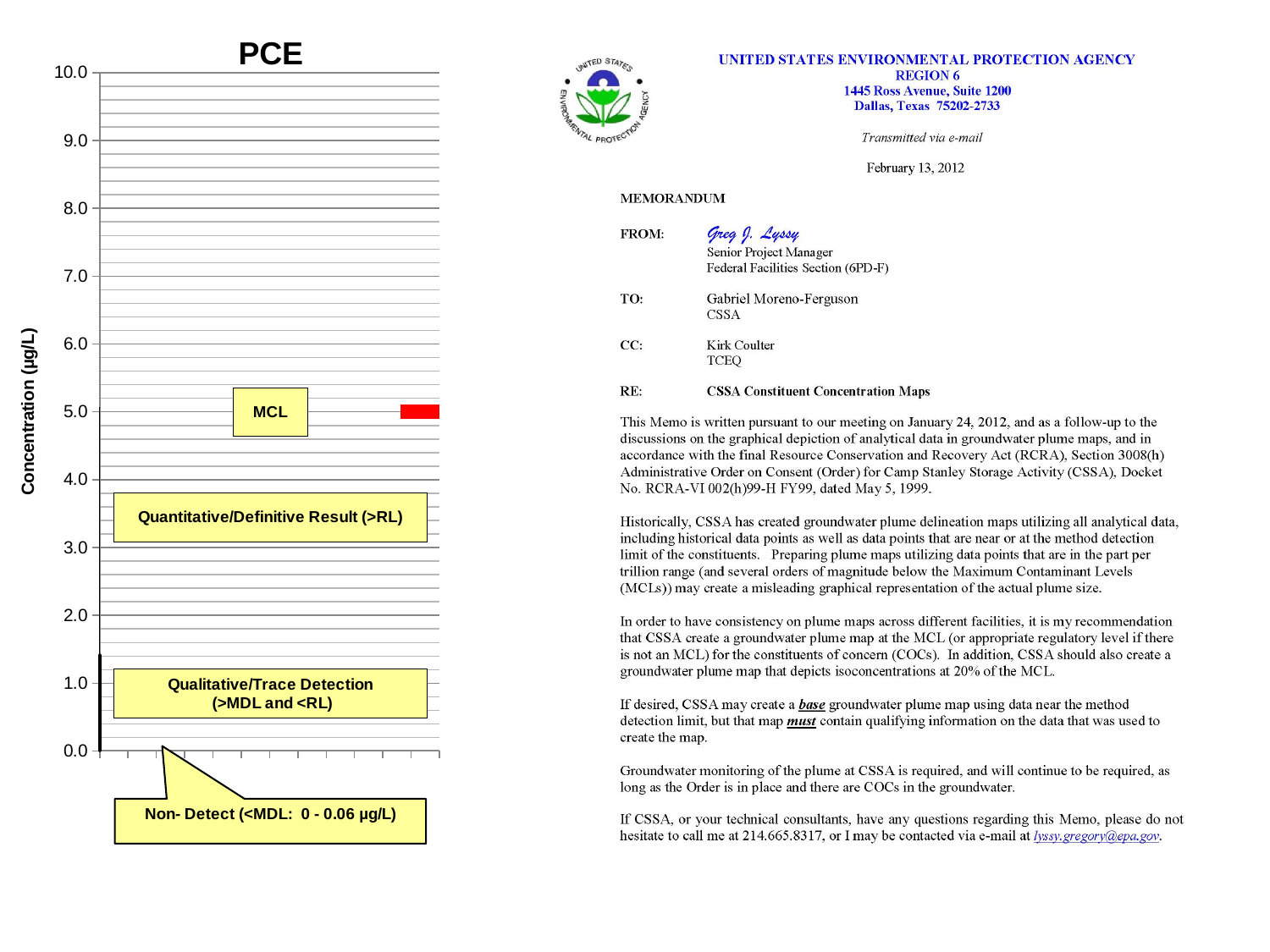
On the PCE chart, what concentration range is given for a Non-Detect result (<MDL)? 0 - 0.06 µg/L What is the label of the y-axis on the PCE chart? Concentration (µg/L) What is the title of the chart on the left of the slide? PCE On the PCE chart, is the MCL marker greater or less than 6.0 µg/L? less How many charts are shown on the slide? 1 On the PCE chart, at what concentration is the MCL marker (red bar) placed? 5.0 On the PCE chart, which is higher on the concentration axis: the MCL marker or the Qualitative/Trace Detection band? MCL marker On the PCE chart, is the top of the black bar at the left edge greater or less than 2.0 µg/L? less On the PCE chart, is the MCL marker greater or less than 4.0 µg/L? greater